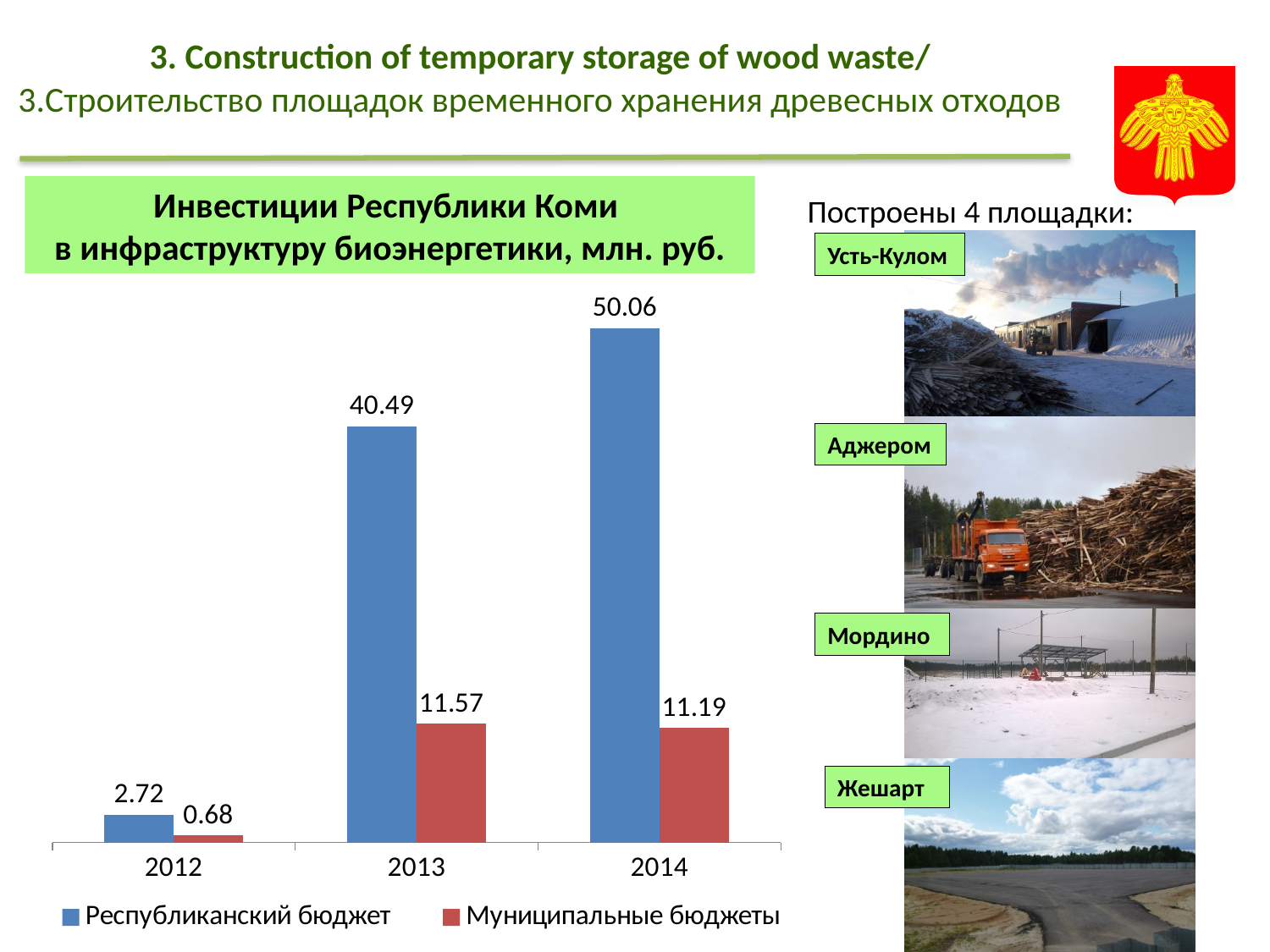
Does the Республиканский бюджет value rise or fall from 2012 to 2014? rise What is the value for Муниципальные бюджеты in 2013? 11.57 In which year is the Муниципальные бюджеты value lowest? 2012 What is the value for Республиканский бюджет in 2014? 50.06 What is the difference between the Республиканский бюджет values for 2014 and 2013? 9.57 How many series does the legend list? 2 What kind of chart is shown? bar chart What is the value for Муниципальные бюджеты in 2012? 0.68 How many years are shown on the x axis? 3 In which year is the Республиканский бюджет value highest? 2014 Which is larger: Муниципальные бюджеты in 2013 or in 2014? 2013 What is the value for Республиканский бюджет in 2012? 2.72